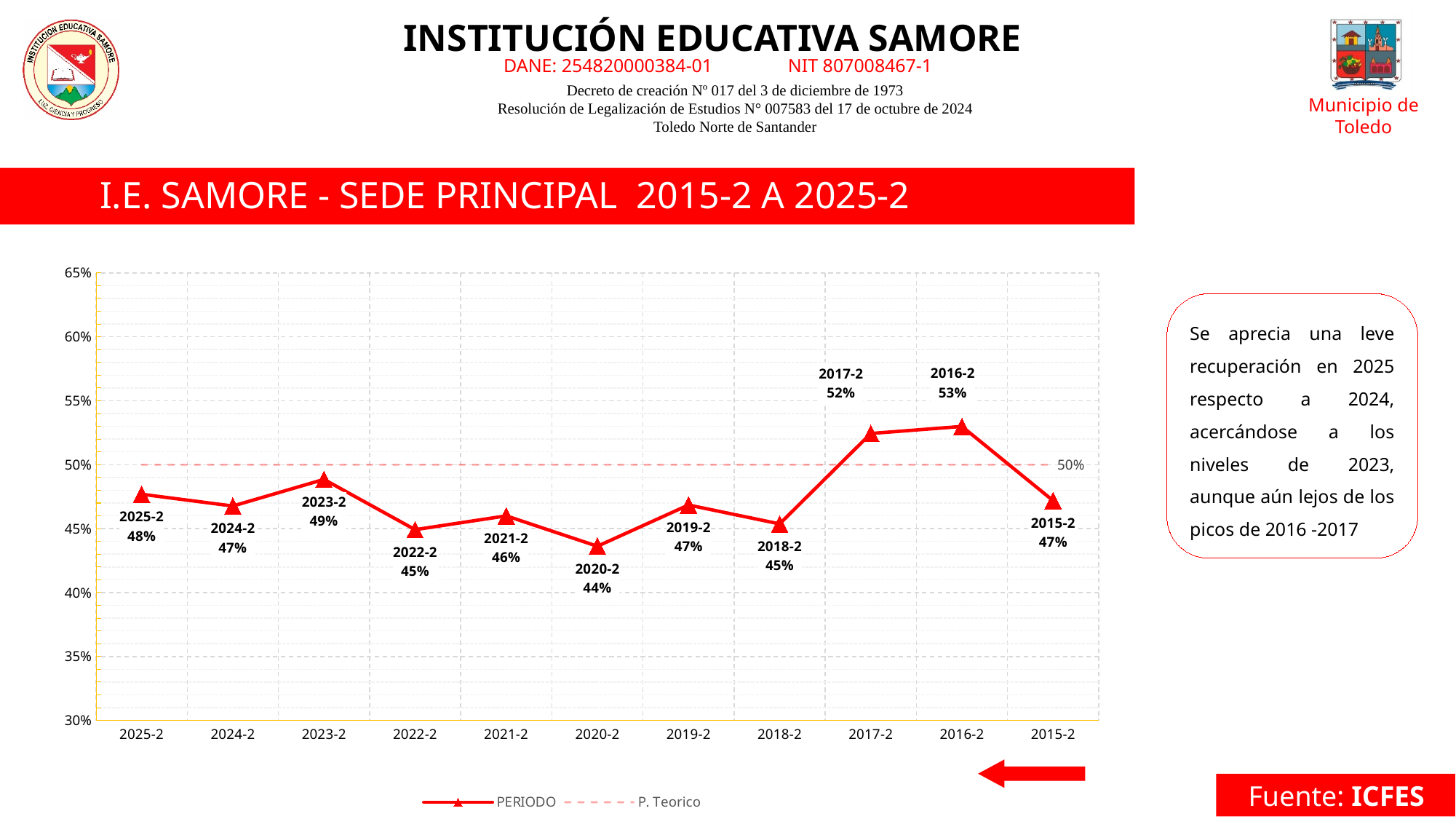
How many series does the legend list? 2 Which period has the lowest value? 2020-2 What is the difference between the values for 2016-2 and 2020-2? 9% What is the value for 2020-2? 44% What is the value for 2017-2? 52% What kind of chart is this? line chart What value does the dashed P. Teorico line mark? 50% Is the value for 2017-2 greater or less than 50%? greater Which is larger, the value for 2023-2 or the value for 2022-2? 2023-2 How many periods are shown on the x axis? 11 Which period has the highest value? 2016-2 What is the value for 2025-2? 48%